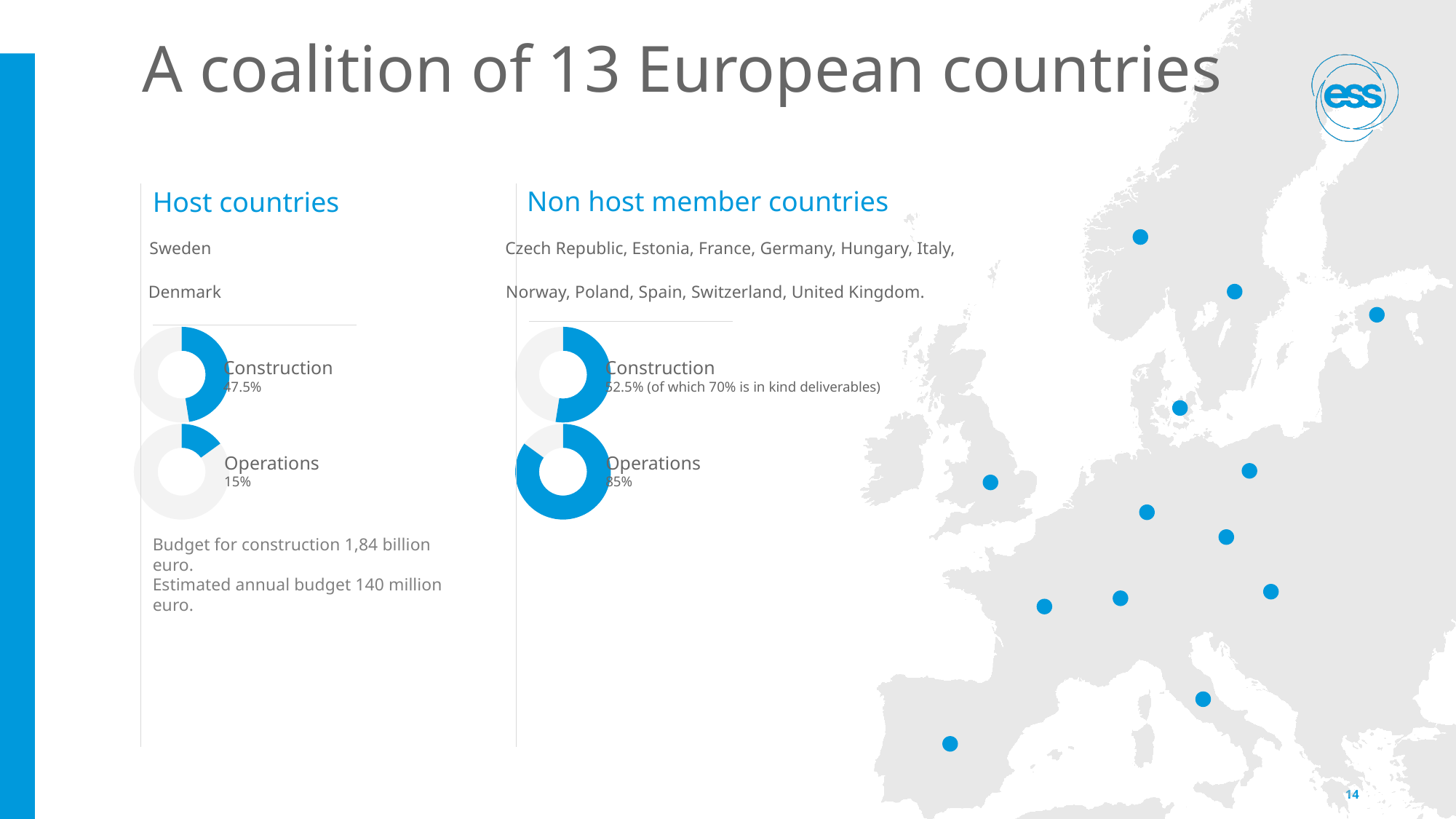
What is the title of the slide containing these charts? A coalition of 13 European countries Which is larger: the construction share for host countries or for non host member countries? Non host member countries What is the difference in percentage points between the non host member countries' operations share and the host countries' operations share? 70 percentage points What kind of chart is used to show the construction and operations shares on this slide? Donut (pie) chart How many donut charts are shown on the slide? 4 In the Host countries section, what share of construction is shown in the donut chart? 47.5% In the Non host member countries section, what share of construction is shown in the donut chart? 52.5% In the Non host member countries section, what share of operations is shown in the donut chart? 85% Which is larger: the operations share for host countries or for non host member countries? Non host member countries What is the difference in percentage points between the non host member countries' construction share and the host countries' construction share? 5 percentage points Of the four donut charts, which one shows the smallest share? Host countries Operations (15%) In the Host countries section, what share of operations is shown in the donut chart? 15%